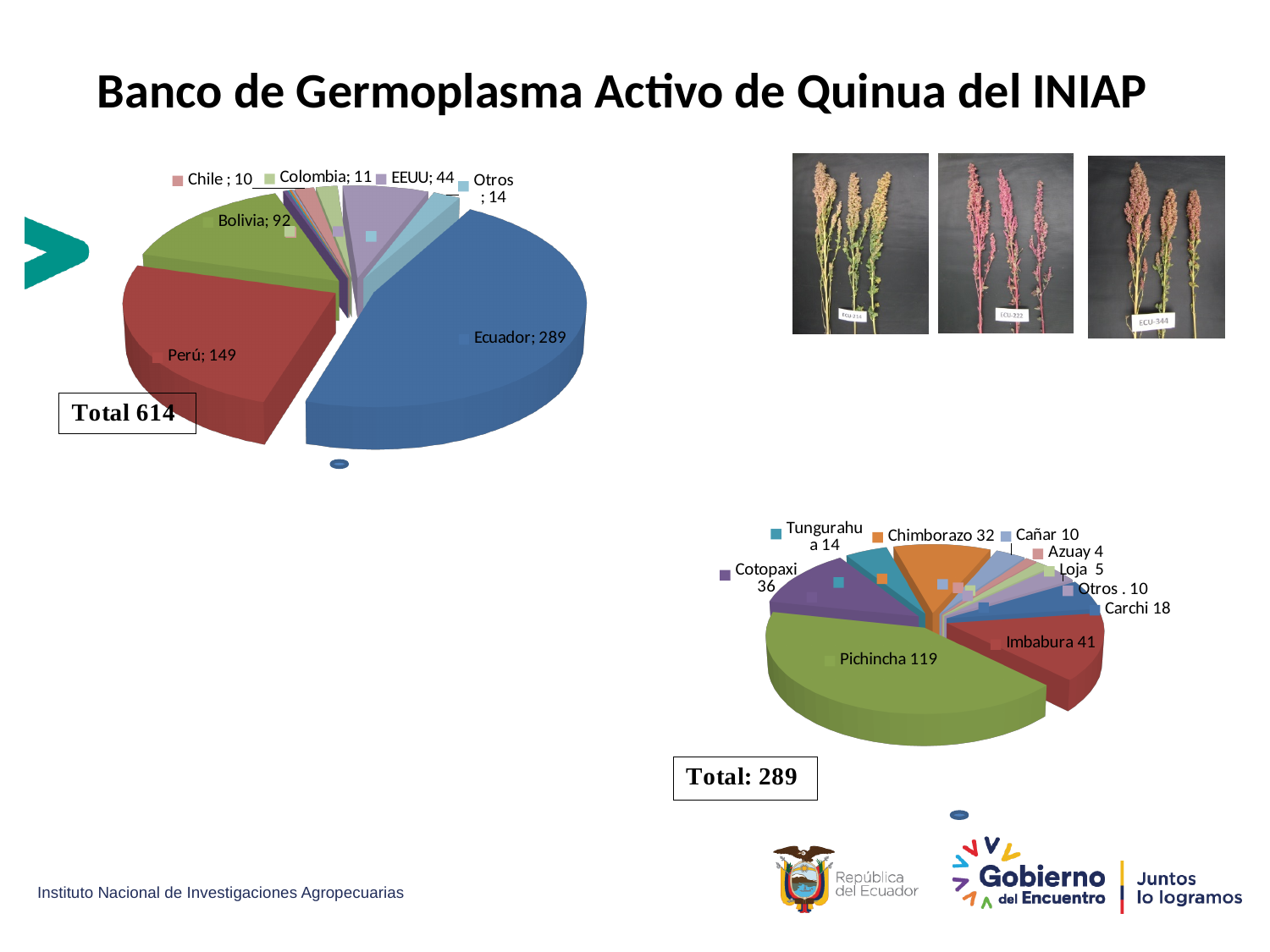
In the top-left pie chart, what is the difference between the values for Ecuador and Perú? 140 In the top-left pie chart, what is the value for Bolivia? 92 What type of chart is the bottom-right chart? Pie chart In the bottom-right pie chart, what share of the total of 289 does Pichincha represent? 41.2% In the bottom-right pie chart, what is the difference between Imbabura and Cotopaxi? 5 In the top-left pie chart, which country has the largest slice? Ecuador In the top-left pie chart, what is the value for Ecuador? 289 How many categories does the top-left pie chart show? 11 In the bottom-right pie chart, what is the value for Chimborazo? 32 In the top-left pie chart, which is larger, EEUU or Colombia? EEUU In the bottom-right pie chart, what is the value for Pichincha? 119